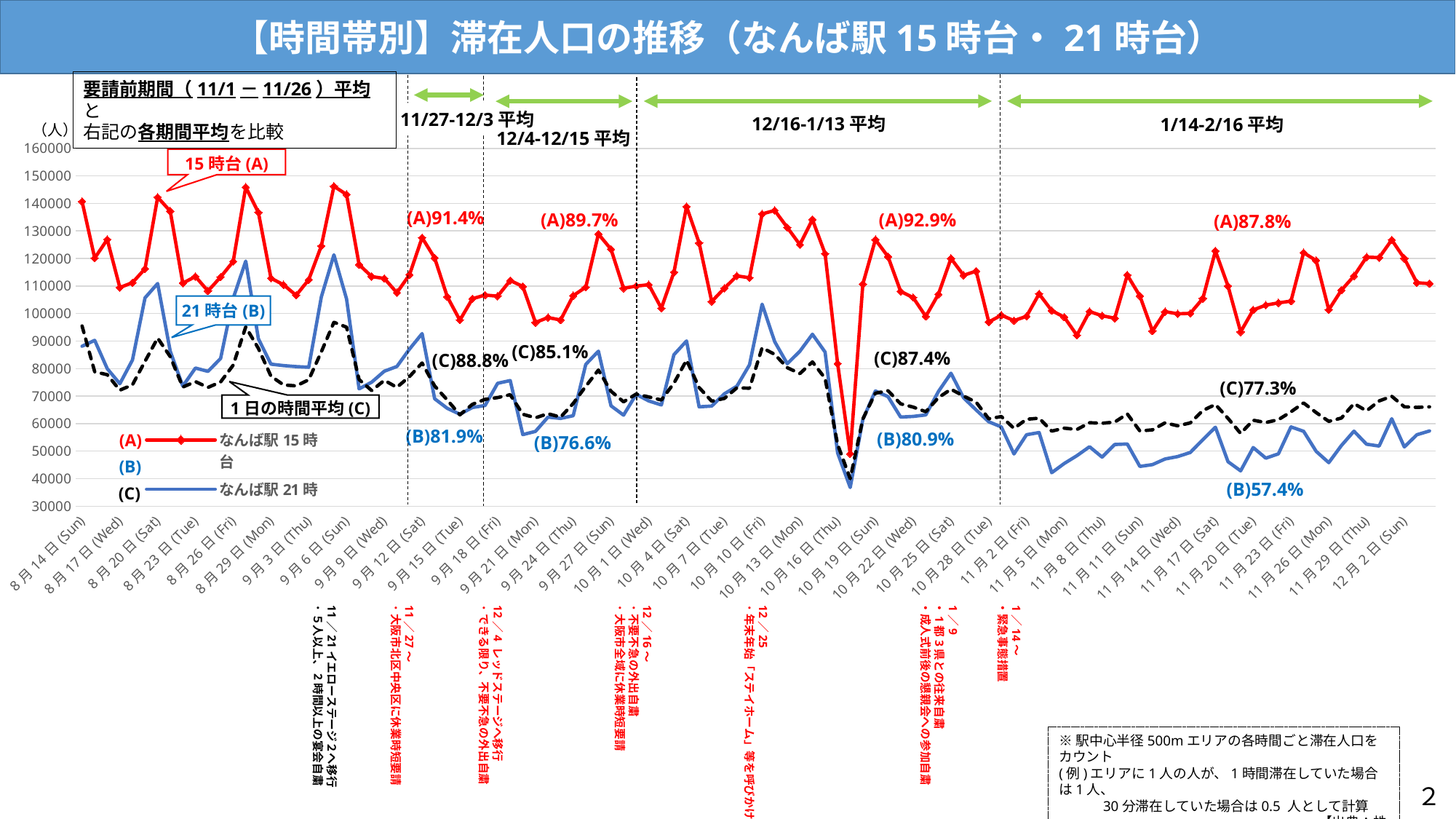
What is the (C) percentage shown for the 12/16-1/13 period? 87.4% What is the (A) percentage shown for the 11/27-12/3 period? 91.4% On 8月14日(Sun), which is higher, なんば駅15時台 or なんば駅21時台? なんば駅15時台 Which period has the lowest (B) percentage? 1/14-2/16 What is the (B) percentage shown for the 1/14-2/16 period? 57.4% How many series does the chart's legend list? 3 What type of chart is shown on the slide? line chart Does the なんば駅21時台 line generally rise or fall from 8月14日 to 12月2日? fall What colour is the line for なんば駅15時台 (A)? red What is the (B) percentage shown for the 12/4-12/15 period? 76.6% Is the value for なんば駅15時台 on 8月14日(Sun) greater or less than 130000? greater What is the difference between the (A) percentage for 12/16-1/13 and the (A) percentage for 1/14-2/16? 5.1 percentage points